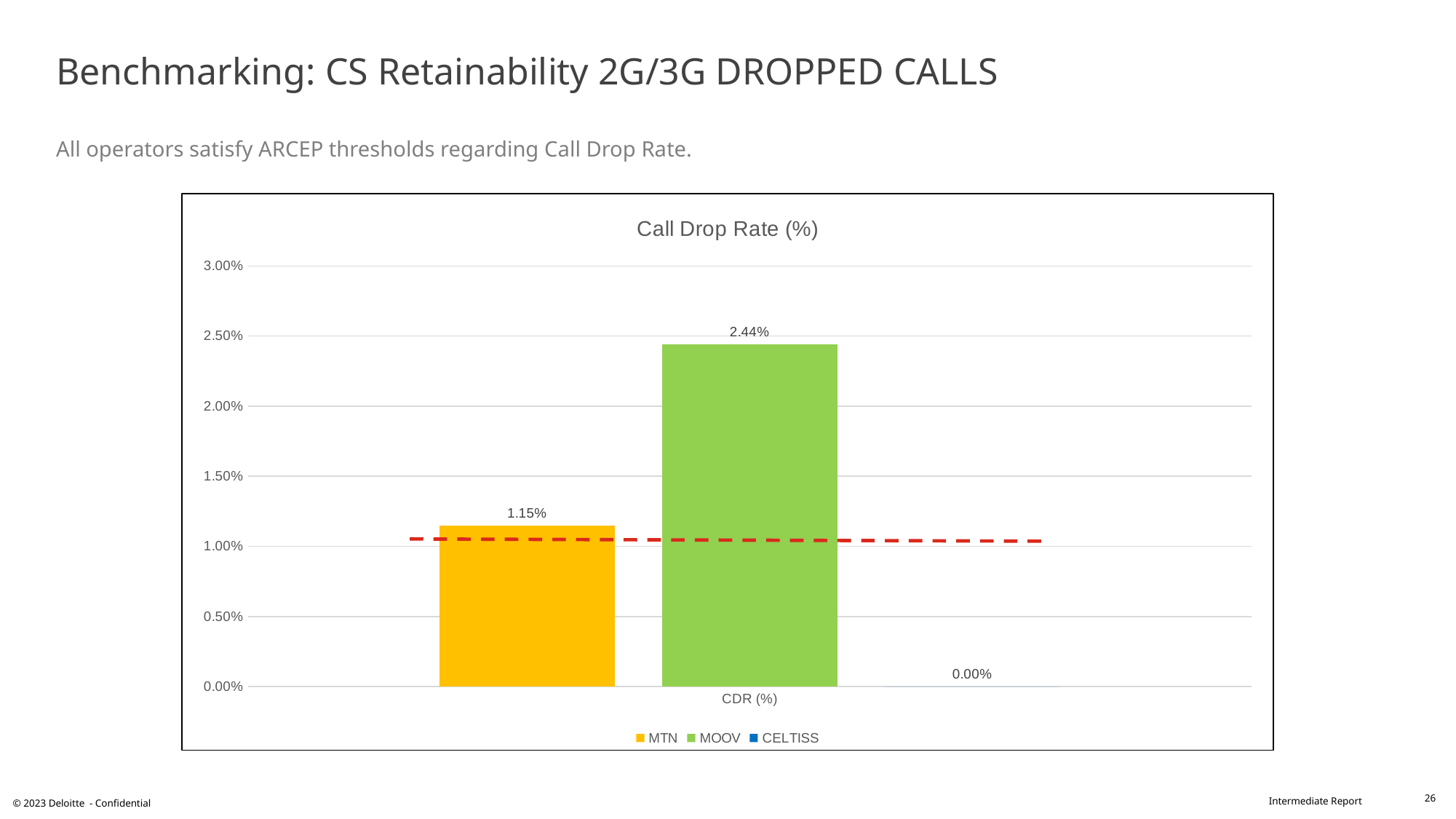
Which operator has the lowest Call Drop Rate? CELTISS What kind of chart is shown on the slide? Bar chart Which operator has the highest Call Drop Rate? MOOV What is the Call Drop Rate for MOOV? 2.44% Is the Call Drop Rate for MOOV greater or less than 2.00%? greater What colour is the bar for MOOV? Green How many series does the legend list? 3 What is the difference between the Call Drop Rate of MOOV and MTN? 1.29% What is the title of the chart? Call Drop Rate (%) What is the Call Drop Rate for CELTISS? 0.00% What is the Call Drop Rate for MTN? 1.15% Which has a higher Call Drop Rate, MTN or MOOV? MOOV